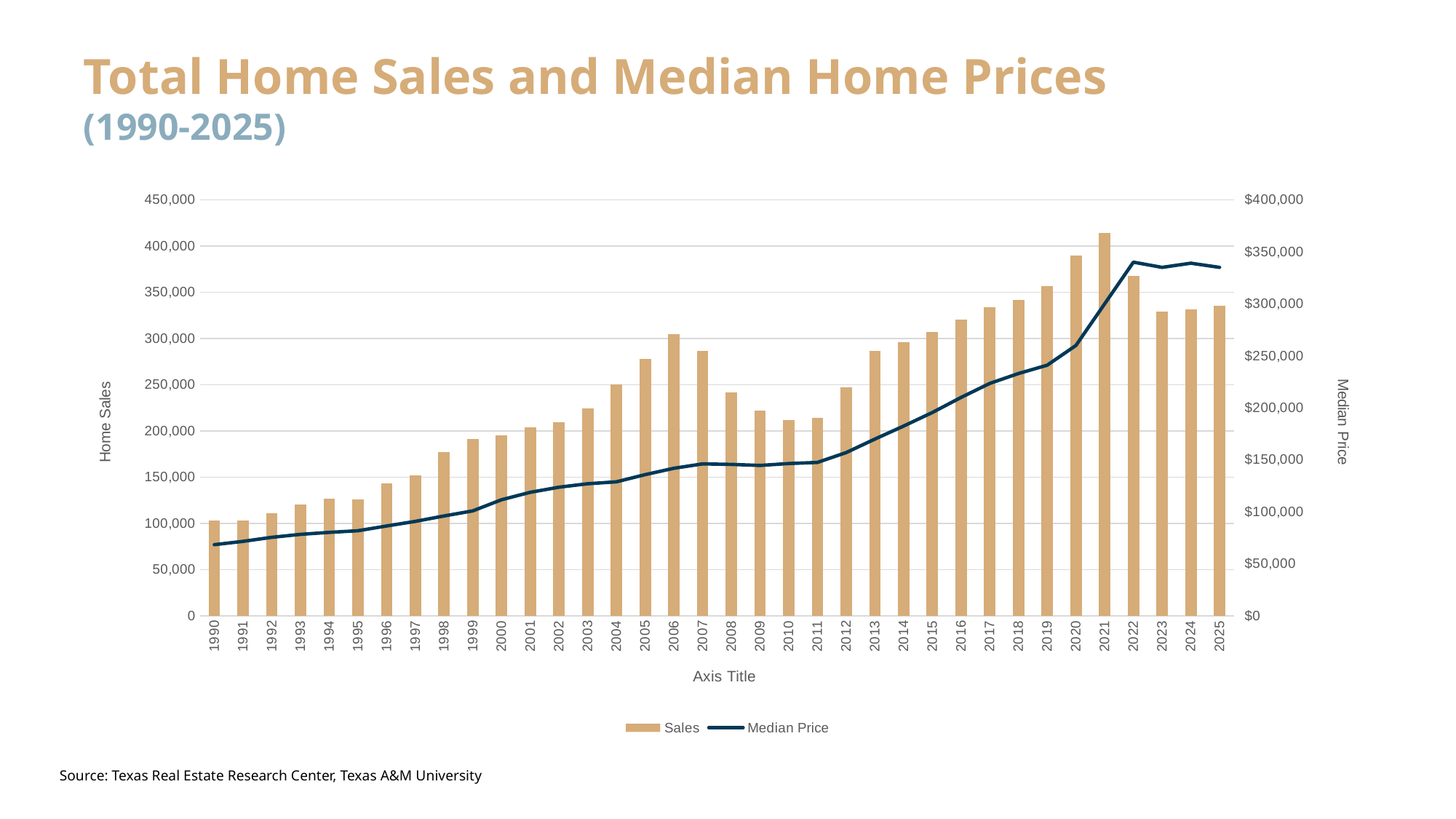
Is the median price for 2011 greater or less than $200,000? less Which year has the highest home sales? 2021 How many years are shown on the x axis? 36 Does the median price generally rise or fall from 1990 to 2025? rise Is the median price for 2025 greater or less than $300,000? greater Which year has the lowest median price? 1990 What is the label of the right-hand vertical axis? Median Price What type of chart is shown on the slide? A combination bar and line chart Is the home sales value for 2021 greater or less than 400,000? greater Which year had higher home sales, 2006 or 2007? 2006 How many series does the legend list? 2